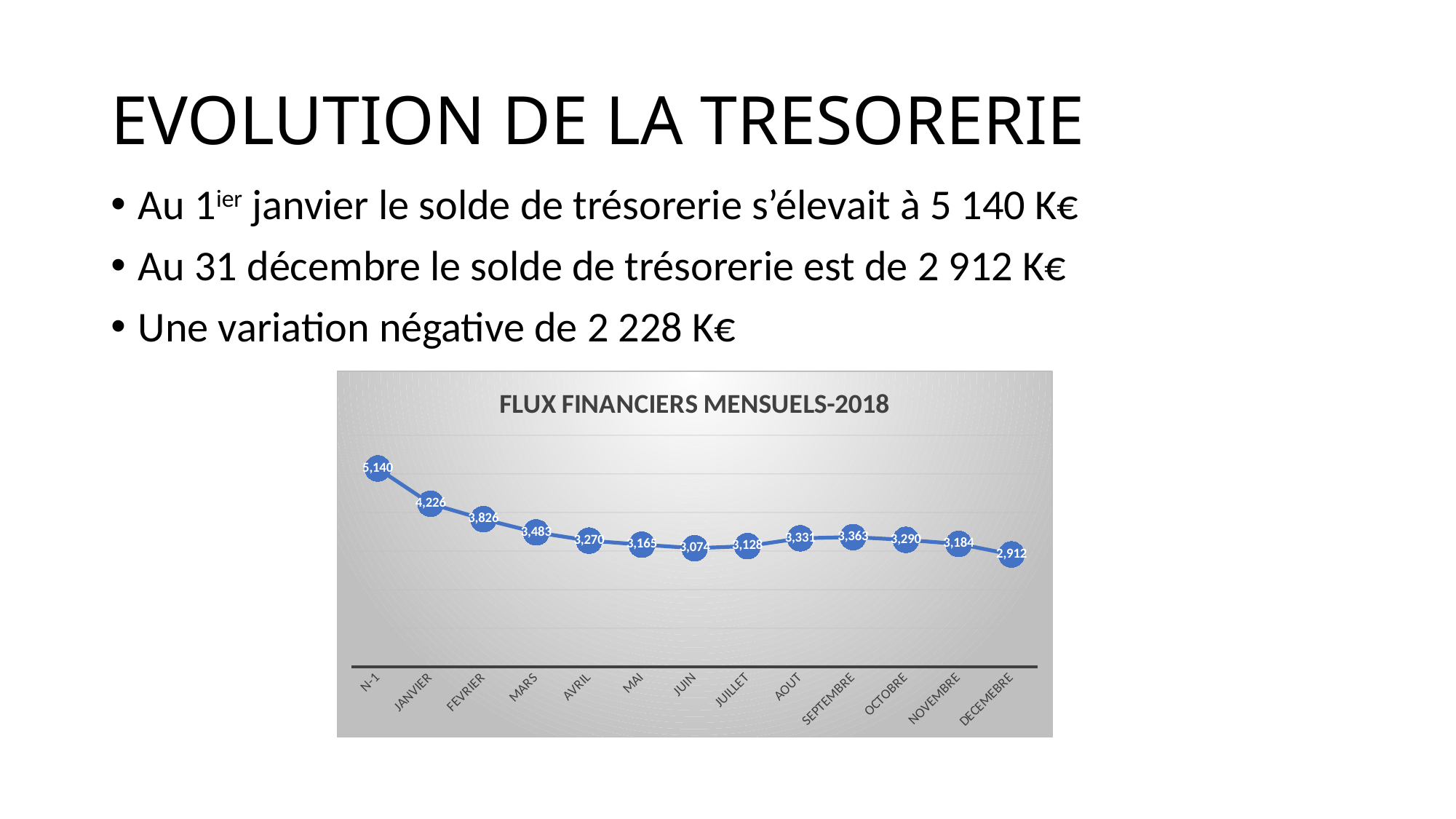
Which category has the lowest value? DECEMEBRE Which category has the highest value? N-1 What is the value for DECEMEBRE? 2,912 What is the value for SEPTEMBRE? 3,363 What is the title of the chart? FLUX FINANCIERS MENSUELS-2018 What is the difference between the values for N-1 and DECEMEBRE? 2,228 What kind of chart is shown? Line chart What is the value for JANVIER? 4,226 How many data points are plotted on the chart? 13 What is the difference between the values for JANVIER and FEVRIER? 400 Which is larger, the value for AOUT or the value for JUILLET? AOUT What is the value for JUIN? 3,074